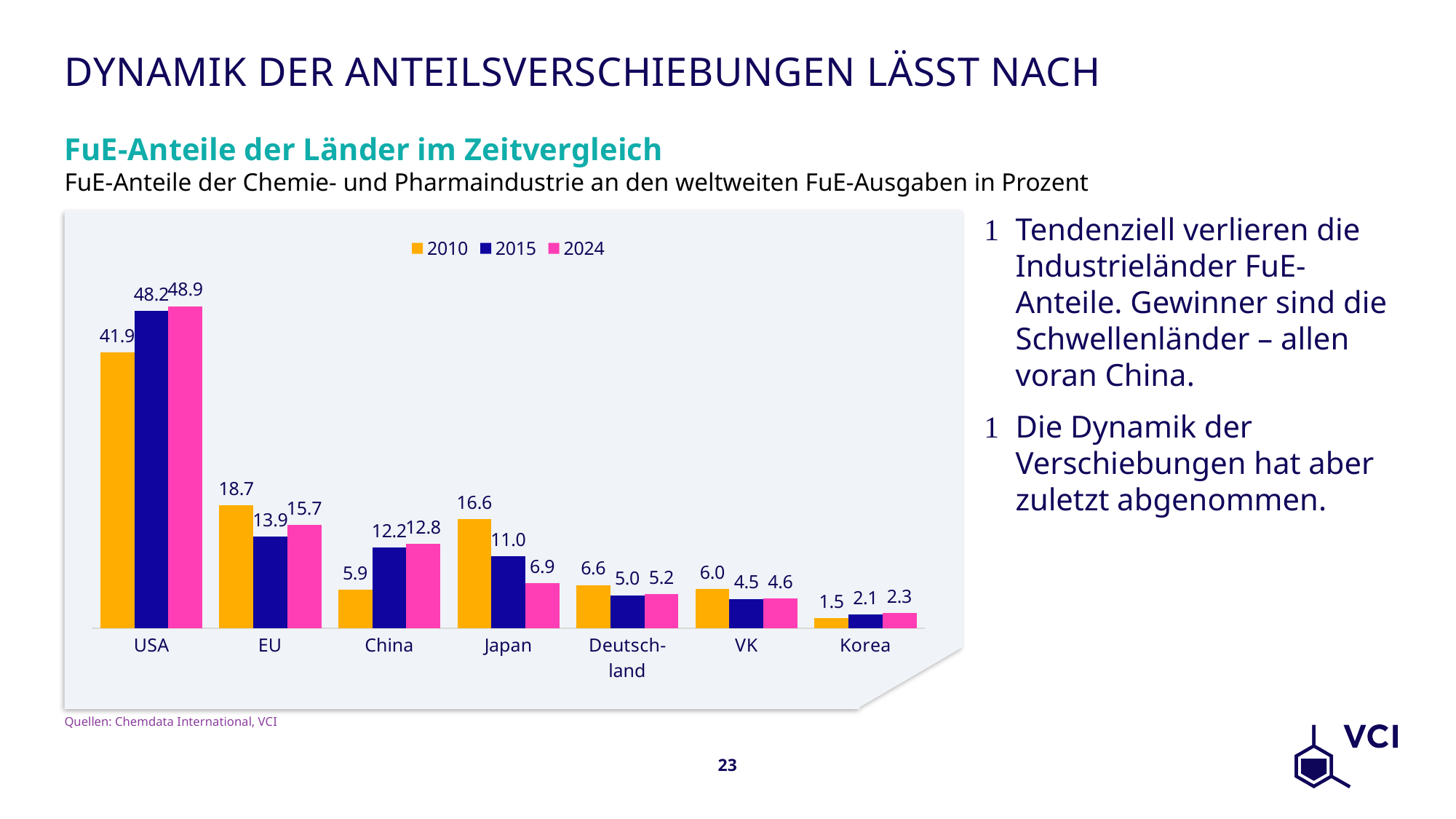
Which years are listed in the legend? 2010, 2015, 2024 How many series does the legend list? 3 Do the values for China rise or fall from 2010 to 2024? Rise Which country has the lowest value in 2010? Korea What is the difference between the EU's 2010 value and its 2024 value? 3.0 How many countries or regions are shown on the x axis? 7 Which is larger: China's 2024 value or Japan's 2024 value? China's 2024 value What is the value for USA in 2024? 48.9 What is the value for China in 2010? 5.9 What is the value for Japan in 2015? 11.0 What kind of chart is shown? Bar chart Which country has the highest value in 2024? USA